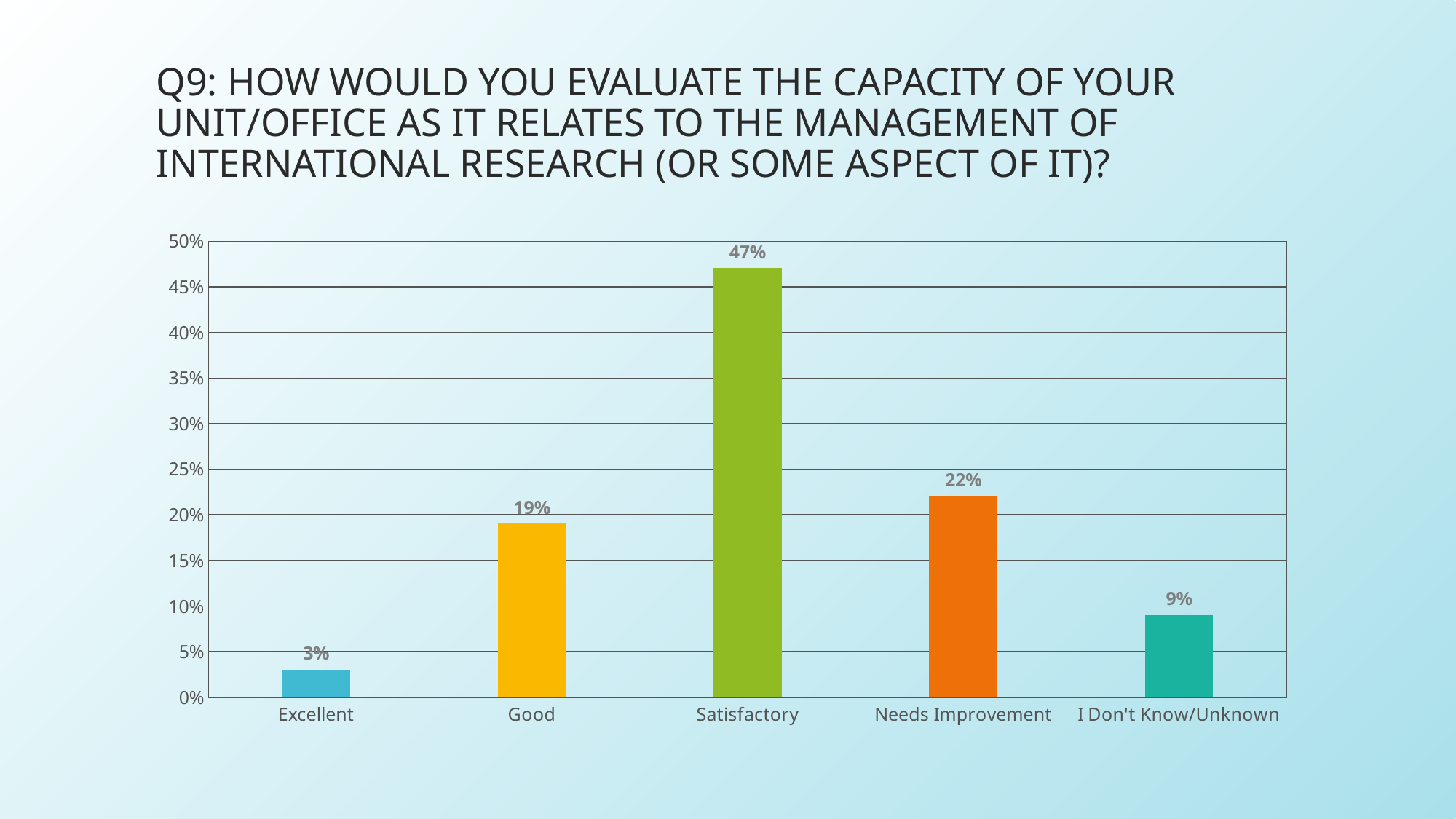
What is the value shown for Needs Improvement? 22% What is the value shown for Excellent? 3% What is the difference between the Satisfactory and Needs Improvement values? 25% Which is larger, the value for Good or the value for Needs Improvement? Needs Improvement Is the value for I Don't Know/Unknown greater or less than 10%? less What is the difference between the Good and I Don't Know/Unknown values? 10% What is the highest value shown on the y axis? 50% Which category has the lowest value? Excellent What percentage of respondents rated their unit/office capacity as Satisfactory? 47% How many categories are shown on the x axis? 5 Which category has the highest value? Satisfactory What kind of chart is shown on the slide? bar chart